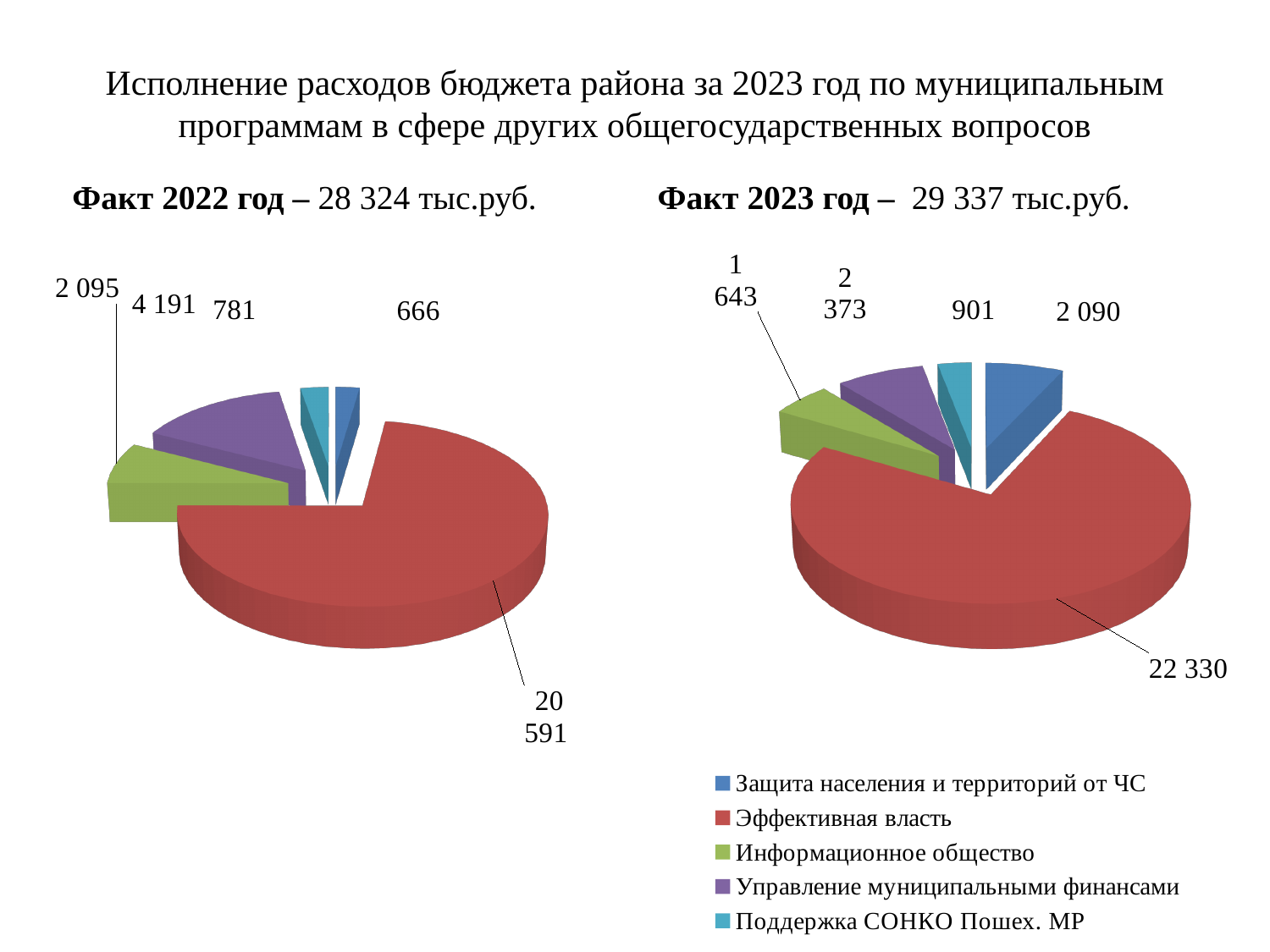
In the 2023 pie chart, which category has the smallest slice? Поддержка СОНКО Пошех. МР In the 2022 pie chart, which is larger: Информационное общество or Управление муниципальными финансами? Управление муниципальными финансами In the 2022 pie chart, which category has the largest slice? Эффективная власть In the 2022 pie chart, what is the value for Управление муниципальными финансами? 4 191 How many categories does the legend list? 5 In the 2023 pie chart, what is the value for Защита населения и территорий от ЧС? 2 090 By how much did the value for Эффективная власть increase from the 2022 chart to the 2023 chart? 1 739 What type of chart is used on this slide? Pie chart What is the difference between the 2022 Информационное общество value and the 2023 Информационное общество value? 452 In the 2022 pie chart (Факт 2022 год), what is the value for Эффективная власть? 20 591 In the 2023 pie chart (Факт 2023 год), what is the value for Эффективная власть? 22 330 How many slices does the 2023 pie chart have? 5